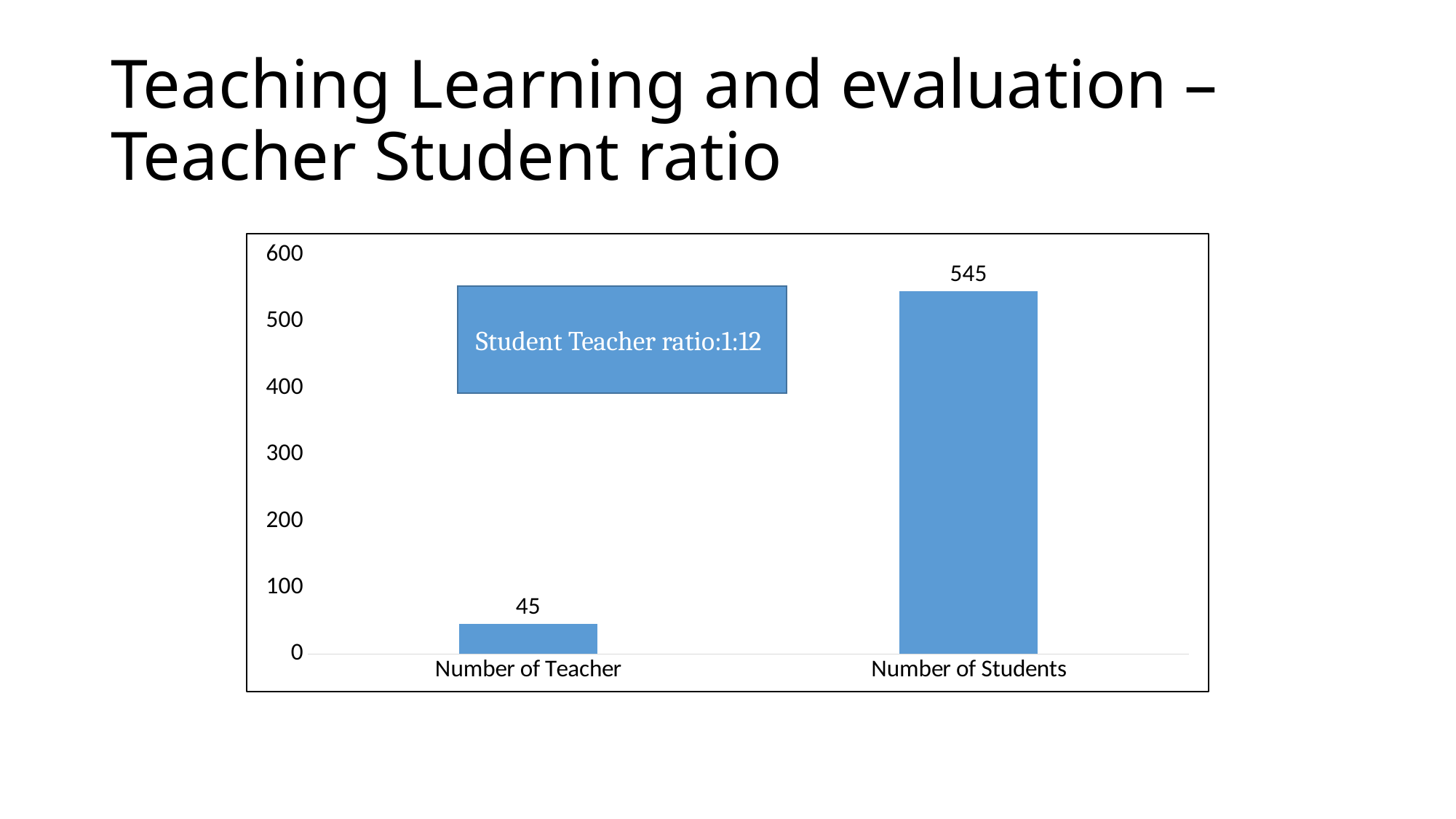
How many categories are shown on the chart? 2 What is the difference between the Number of Students and the Number of Teacher? 500 What is the highest value shown on the vertical axis? 600 Is the value for Number of Teacher greater or less than 100? less What student teacher ratio is stated in the text box on the chart? 1:12 What is the value for Number of Students? 545 Is the value for Number of Students greater or less than 500? greater Which category has the lowest value? Number of Teacher Which category has the highest value? Number of Students What is the value for Number of Teacher? 45 Which is larger, Number of Teacher or Number of Students? Number of Students What kind of chart is shown on the slide? Bar chart